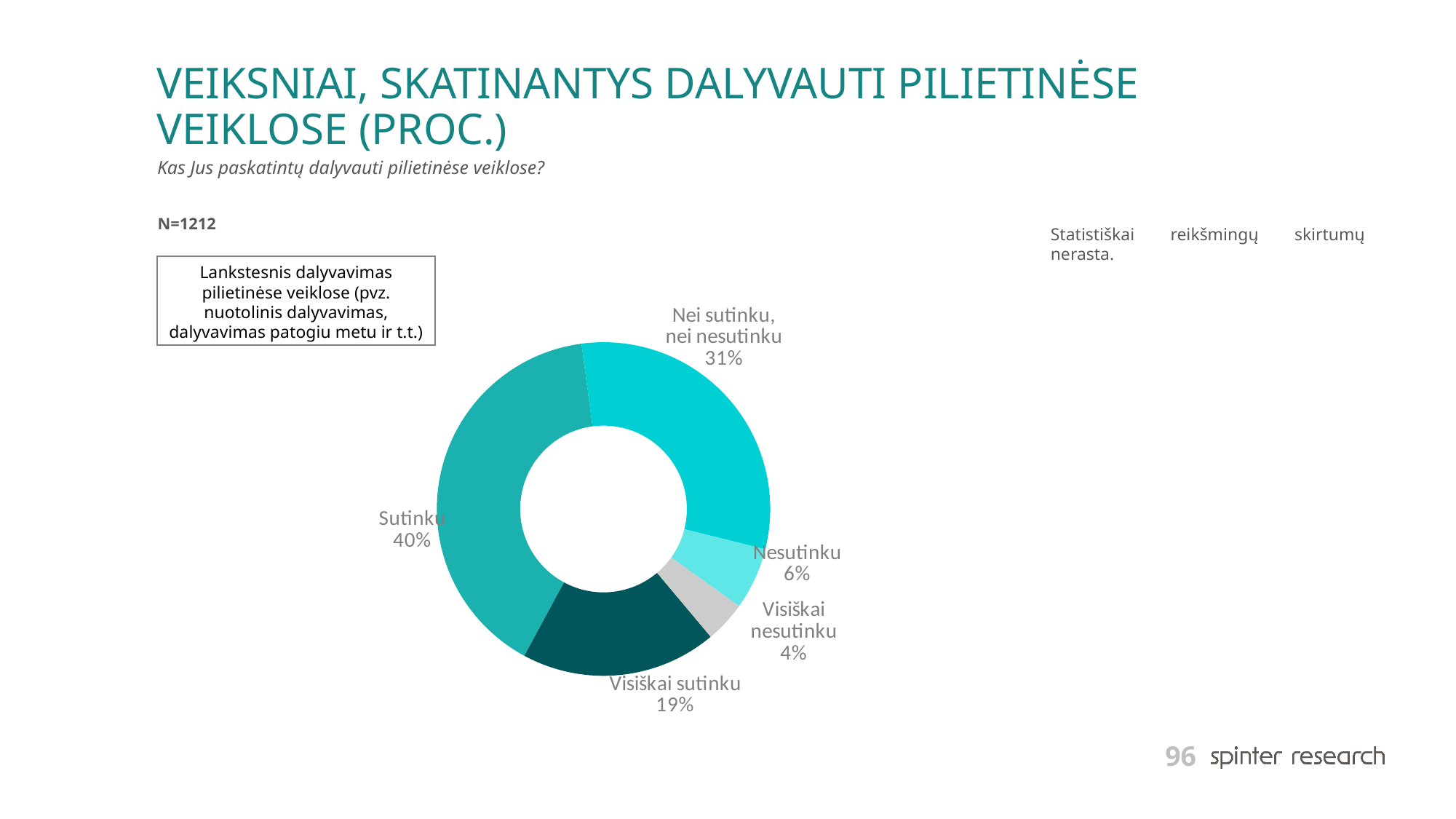
How many response categories are shown in the chart? 5 Which response category has the smallest share? Visiškai nesutinku What is the sample size (N) stated on the slide? N=1212 What kind of chart is shown on the slide? Pie chart (doughnut) What share of respondents answered "Visiškai sutinku"? 19% What share of respondents answered "Nesutinku"? 6% What share of respondents answered "Sutinku"? 40% What is the difference in percentage points between "Sutinku" and "Visiškai sutinku"? 21 Which is larger, the share for "Nei sutinku, nei nesutinku" or the share for "Visiškai sutinku"? Nei sutinku, nei nesutinku Which response category has the largest share? Sutinku What share of respondents answered "Nei sutinku, nei nesutinku"? 31% What share of respondents answered "Visiškai nesutinku"? 4%